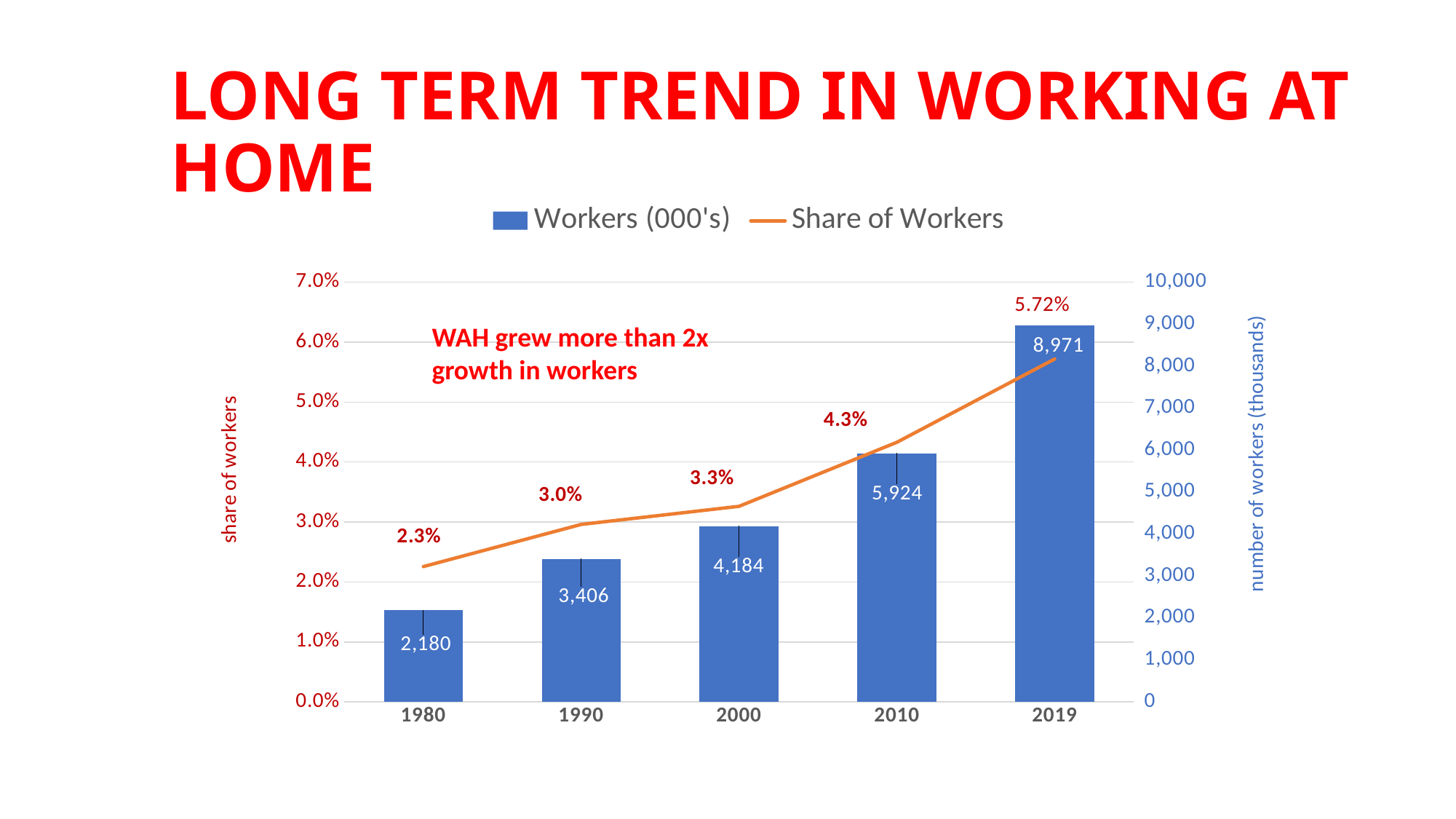
What colour is the Share of Workers line? orange What is the Share of Workers for 2010? 4.3% Do the Workers (000's) values rise or fall from 1980 to 2019? rise How many series does the legend list? 2 Which year has the lowest Share of Workers? 1980 What is the Share of Workers for 1980? 2.3% What is the value of Workers (000's) for 2019? 8,971 Which year has the highest value of Workers (000's)? 2019 How many years are shown on the x axis? 5 What is the value of Workers (000's) for 2000? 4,184 Which year has a larger value of Workers (000's), 1990 or 2010? 2010 What is the difference in Workers (000's) between 2019 and 1980? 6,791